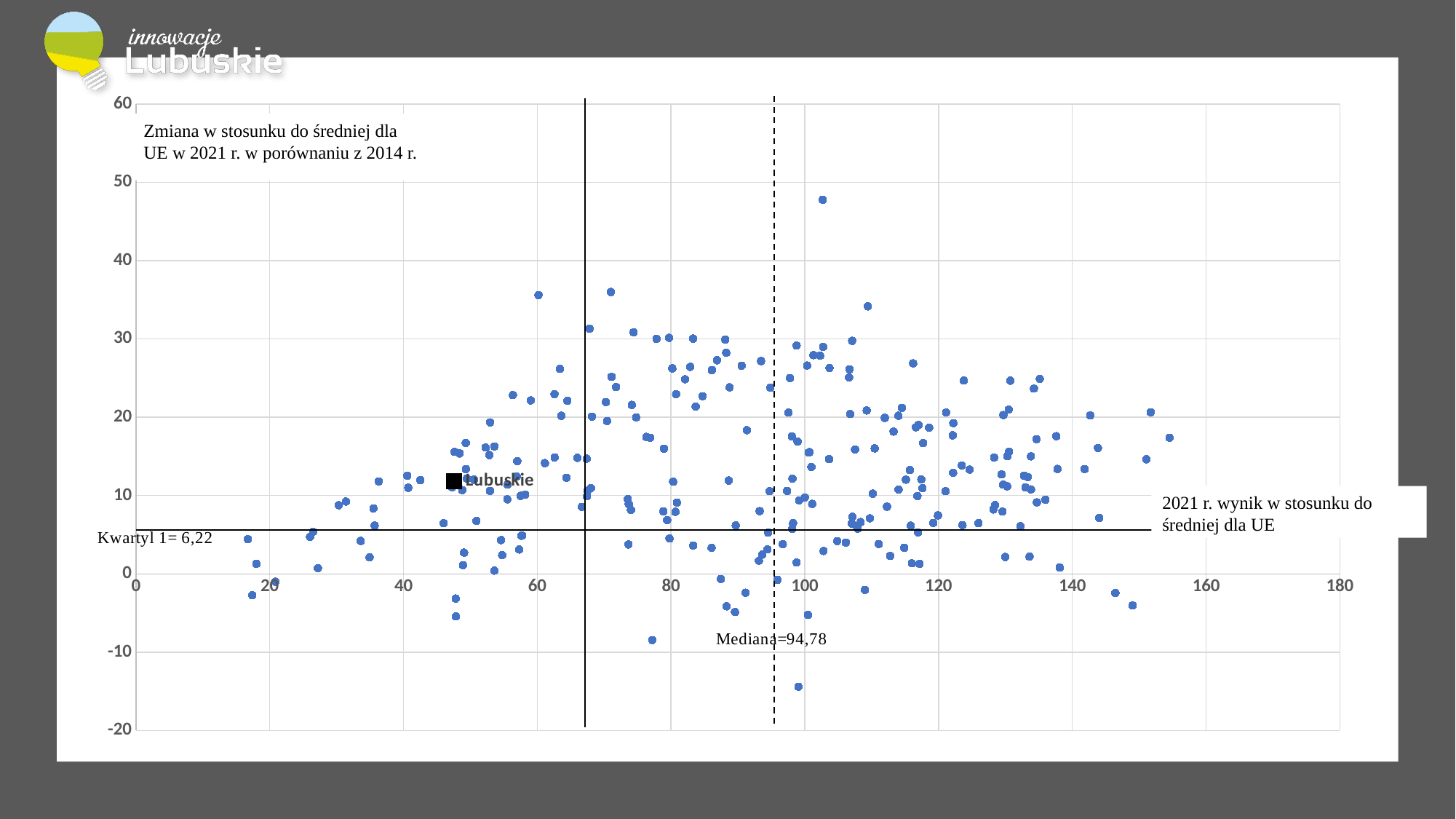
What value is given for the median (Mediana) on the chart? 94,78 Is the horizontal-axis value of the Lubuskie point greater or less than the median line value of 94,78? less Is the horizontal-axis value for the Lubuskie point greater or less than 60? less Is the vertical-axis value of the lowest point on the chart greater or less than -10? less Is the vertical-axis value of the Lubuskie point greater or less than the Kwartyl 1 line value of 6,22? greater Is the vertical-axis value for the Lubuskie point greater or less than 20? less Which point is labelled by name on the chart? Lubuskie What is the maximum value shown on the horizontal axis? 180 What kind of chart is shown on the slide? scatter chart What value is given for the first quartile (Kwartyl 1) on the chart? 6,22